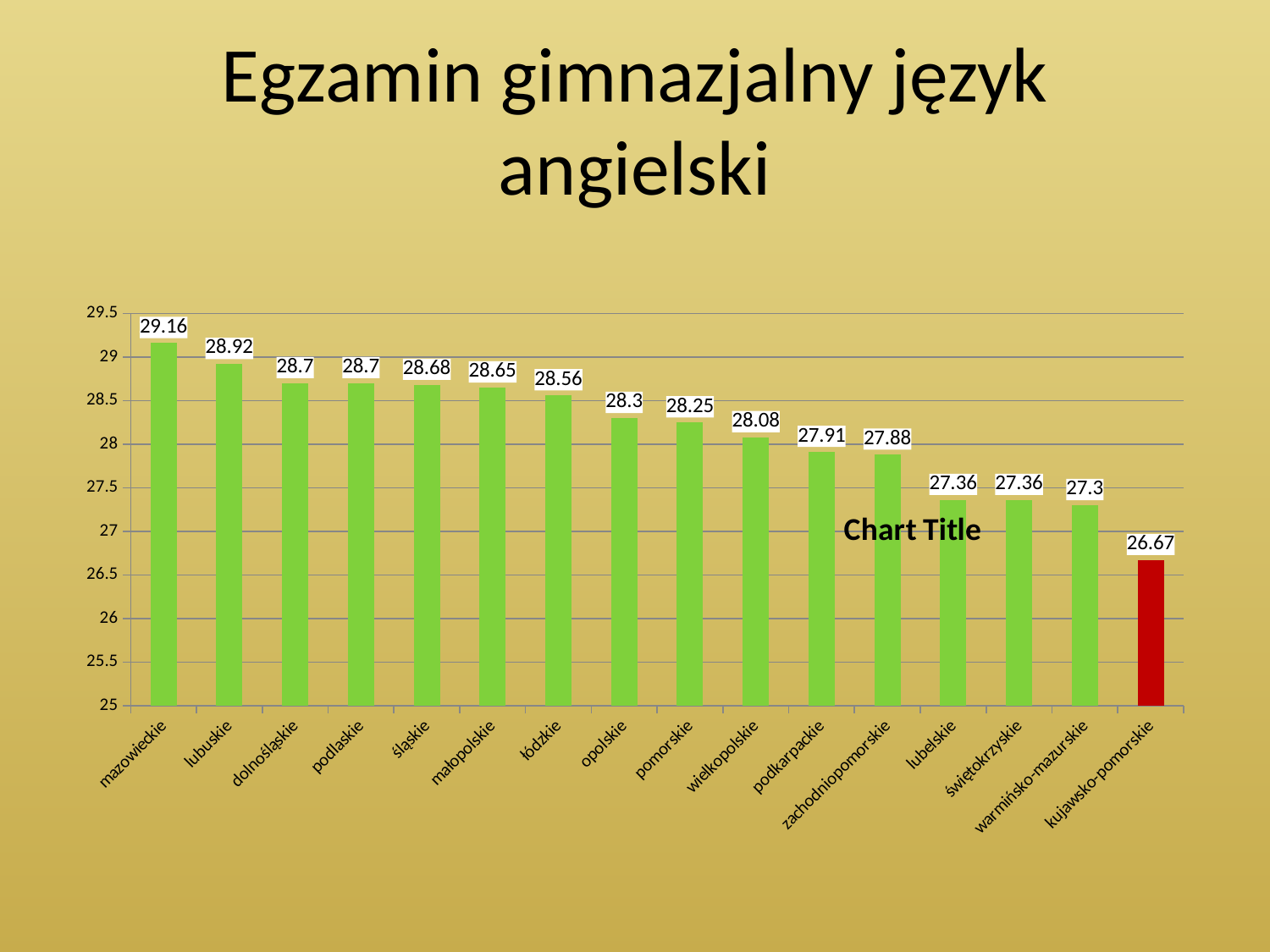
Which category has the highest value? mazowieckie Which bar is shown in a different colour (red) from the others? kujawsko-pomorskie How many categories are shown on the x axis? 16 What is the value for mazowieckie? 29.16 Do the values rise or fall from left to right along the x axis? fall Is the value for wielkopolskie greater or less than 28? greater What is the difference between the values for mazowieckie and kujawsko-pomorskie? 2.49 What kind of chart is shown on the slide? bar chart What is the value for opolskie? 28.3 Which category has the lowest value? kujawsko-pomorskie What is the value for kujawsko-pomorskie? 26.67 Which is larger, the value for lubuskie or the value for pomorskie? lubuskie